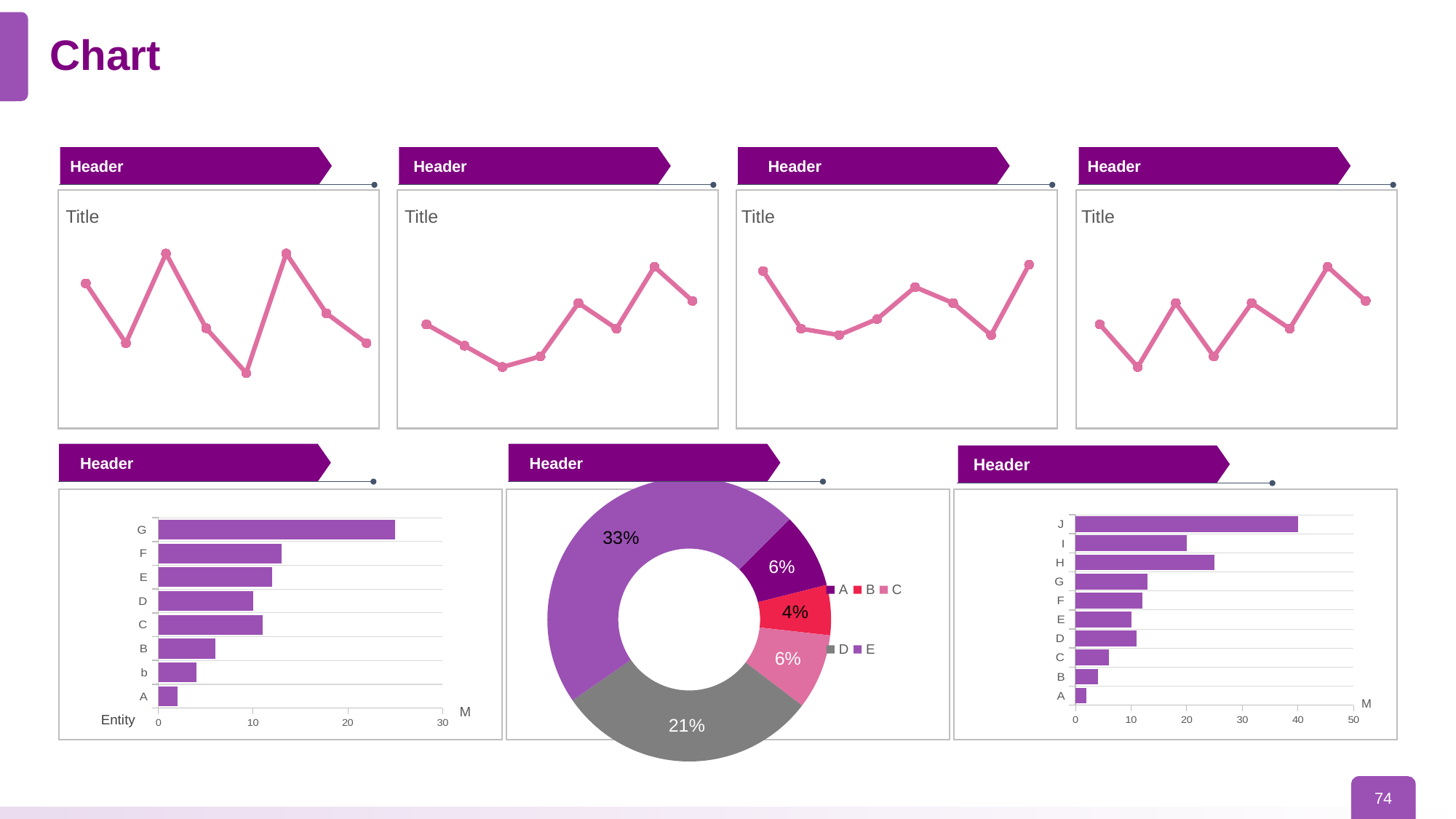
In the bottom-right bar chart, which is larger, H or I? H How many categories does the bottom-left bar chart show? 8 In the bottom-left bar chart, is the value for G greater or less than 20? greater How many entries does the legend of the bottom-middle donut chart list? 5 In the bottom-right bar chart, which category has the highest value? J In the bottom-middle donut chart, which slice is the smallest? B In the bottom-middle donut chart, what share does slice E have? 33% How many categories does the bottom-right bar chart show? 10 In the bottom-left bar chart, which category has the highest value? G What kind of chart is the bottom-middle chart? donut chart In the bottom-right bar chart, is the value for J greater or less than 30? greater What kind of chart is the bottom-left chart? bar chart